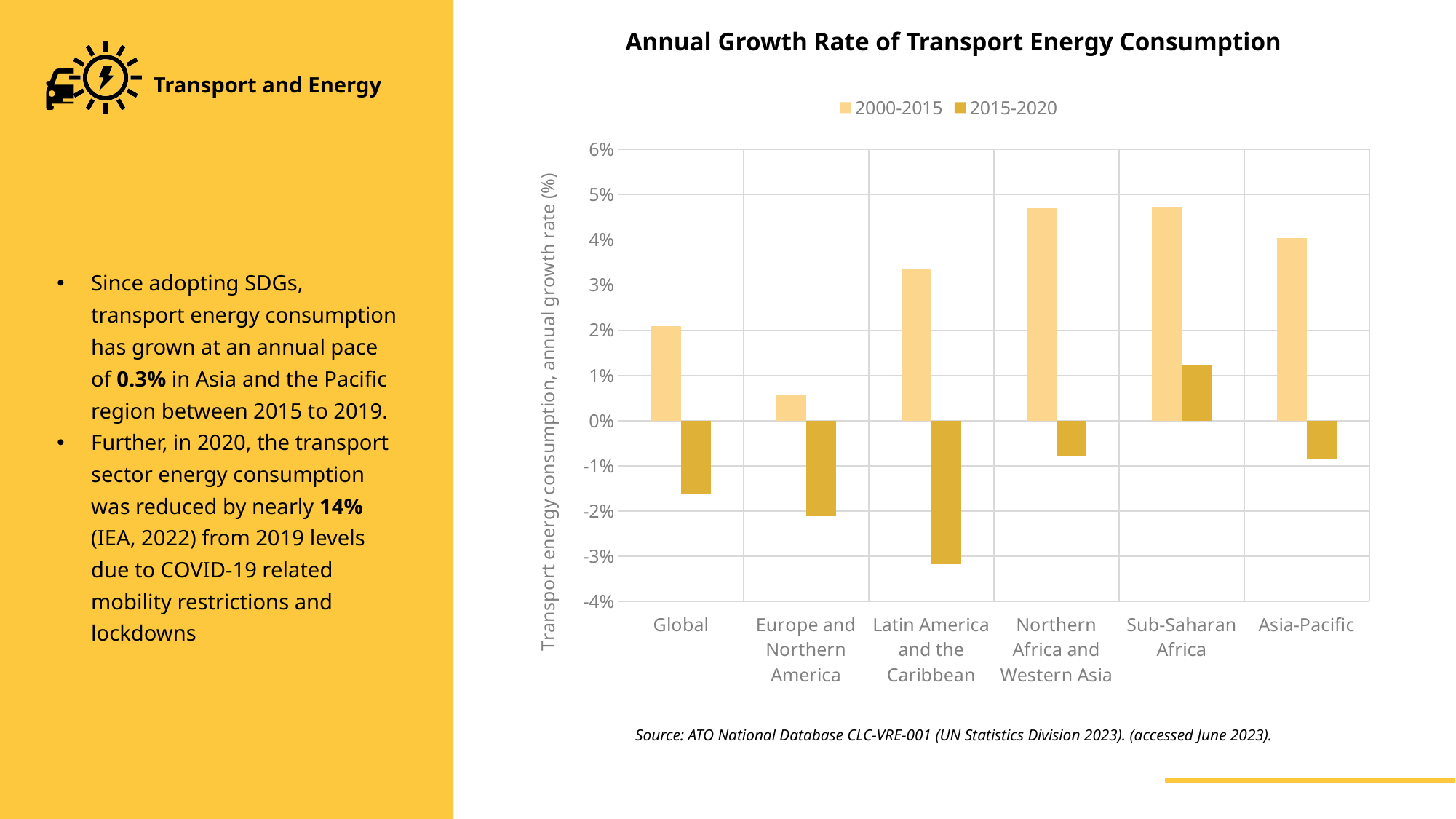
Which region has the lowest value for the 2015-2020 series? Latin America and the Caribbean Which is larger for the 2015-2020 series: Global or Northern Africa and Western Asia? Northern Africa and Western Asia What is the title of the chart? Annual Growth Rate of Transport Energy Consumption Is the 2015-2020 value for Europe and Northern America greater or less than -1%? less Which region has the highest value for the 2015-2020 series? Sub-Saharan Africa Which region has the lowest value for the 2000-2015 series? Europe and Northern America How many series does the legend list? 2 How many regions are shown on the x axis of the chart? 6 Which is larger for the 2000-2015 series: Global or Europe and Northern America? Global Is the 2000-2015 value for Asia-Pacific greater or less than 3%? greater What type of chart is shown on the slide? bar chart Is the 2000-2015 value for Global greater or less than 1%? greater